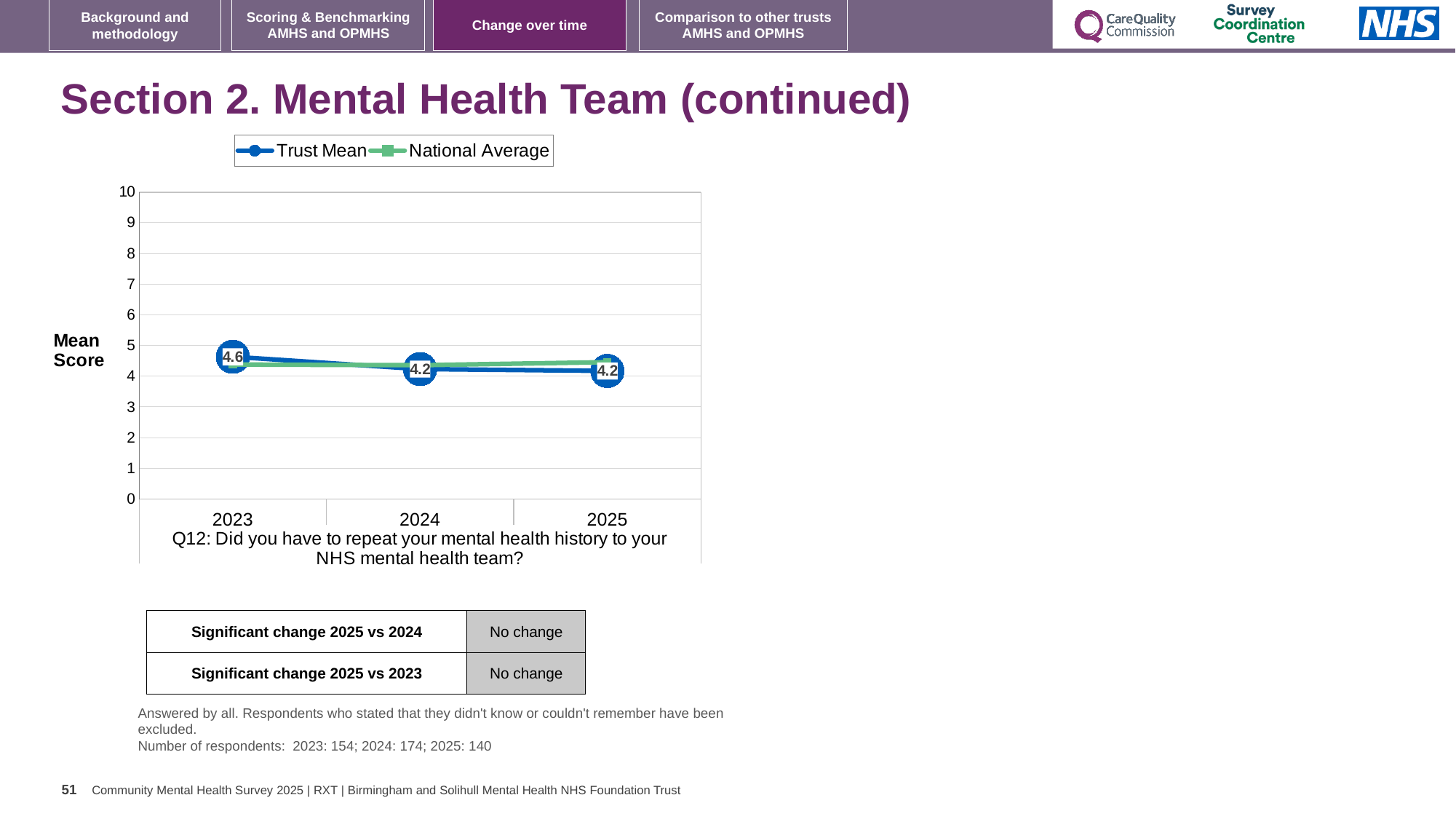
Does the Trust Mean rise or fall from 2023 to 2025? fall What kind of chart is shown? line chart How many years are plotted on the x axis? 3 What is the label on the y axis? Mean Score What is the Trust Mean score for 2025? 4.2 What is the Trust Mean score for 2023? 4.6 Which is larger, the Trust Mean for 2023 or for 2025? 2023 Is the National Average value for 2025 greater or less than 5? less How many series does the legend list? 2 In which year is the Trust Mean highest? 2023 What is the Trust Mean score for 2024? 4.2 What is the difference between the Trust Mean in 2023 and in 2024? 0.4